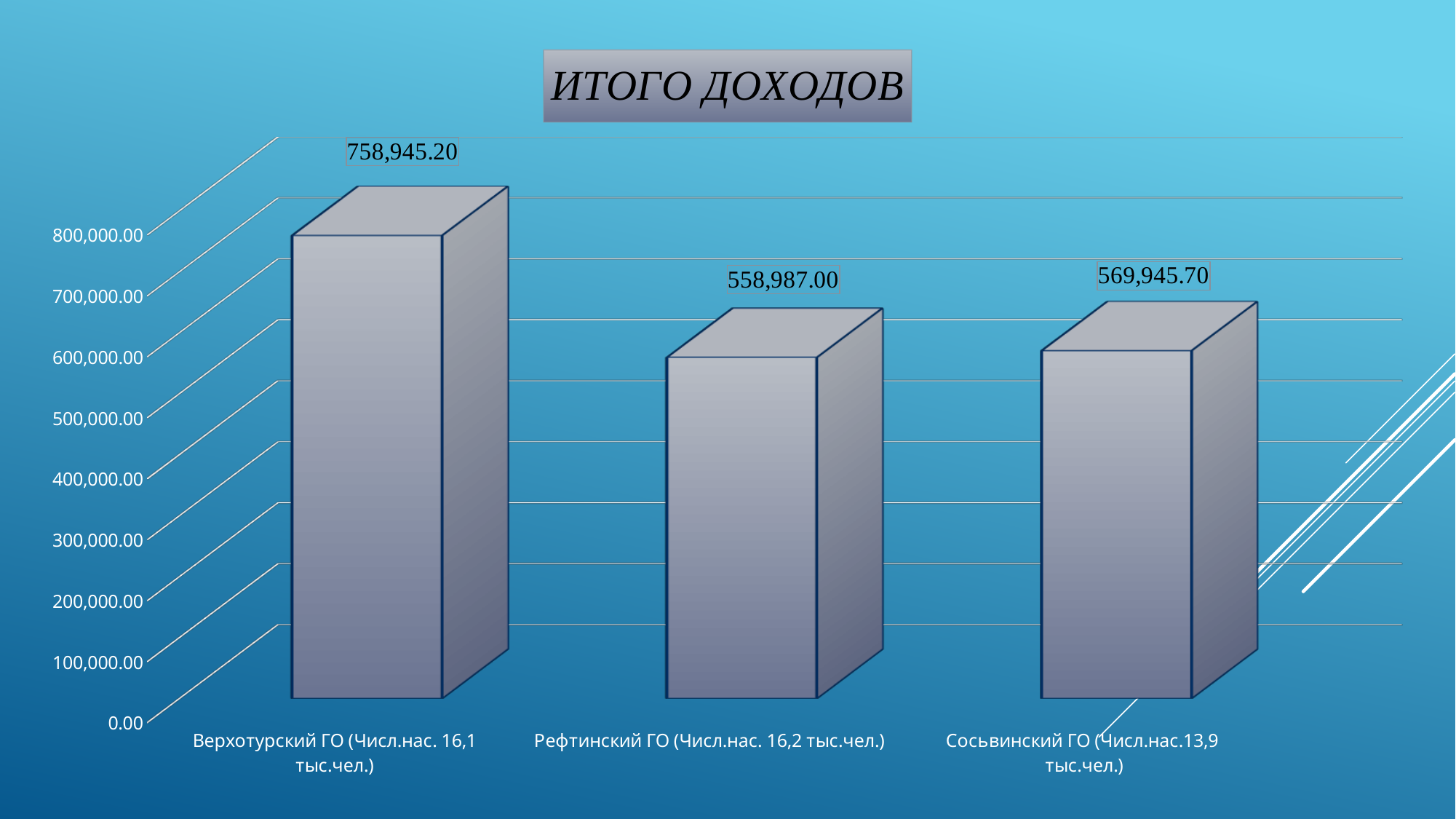
What kind of chart is shown on the slide? bar chart What is the value for Сосьвинский ГО? 569,945.70 What is the value for Рефтинский ГО? 558,987.00 How many categories are shown in the chart? 3 Which category has the highest value? Верхотурский ГО What is the difference between the values for Сосьвинский ГО and Рефтинский ГО? 10,958.70 Which category has the lowest value? Рефтинский ГО Is the value for Верхотурский ГО greater or less than 700,000.00? greater What is the title of the chart? ИТОГО ДОХОДОВ What is the value for Верхотурский ГО? 758,945.20 Which is larger, the value for Сосьвинский ГО or the value for Рефтинский ГО? Сосьвинский ГО What is the difference between the values for Верхотурский ГО and Рефтинский ГО? 199,958.20